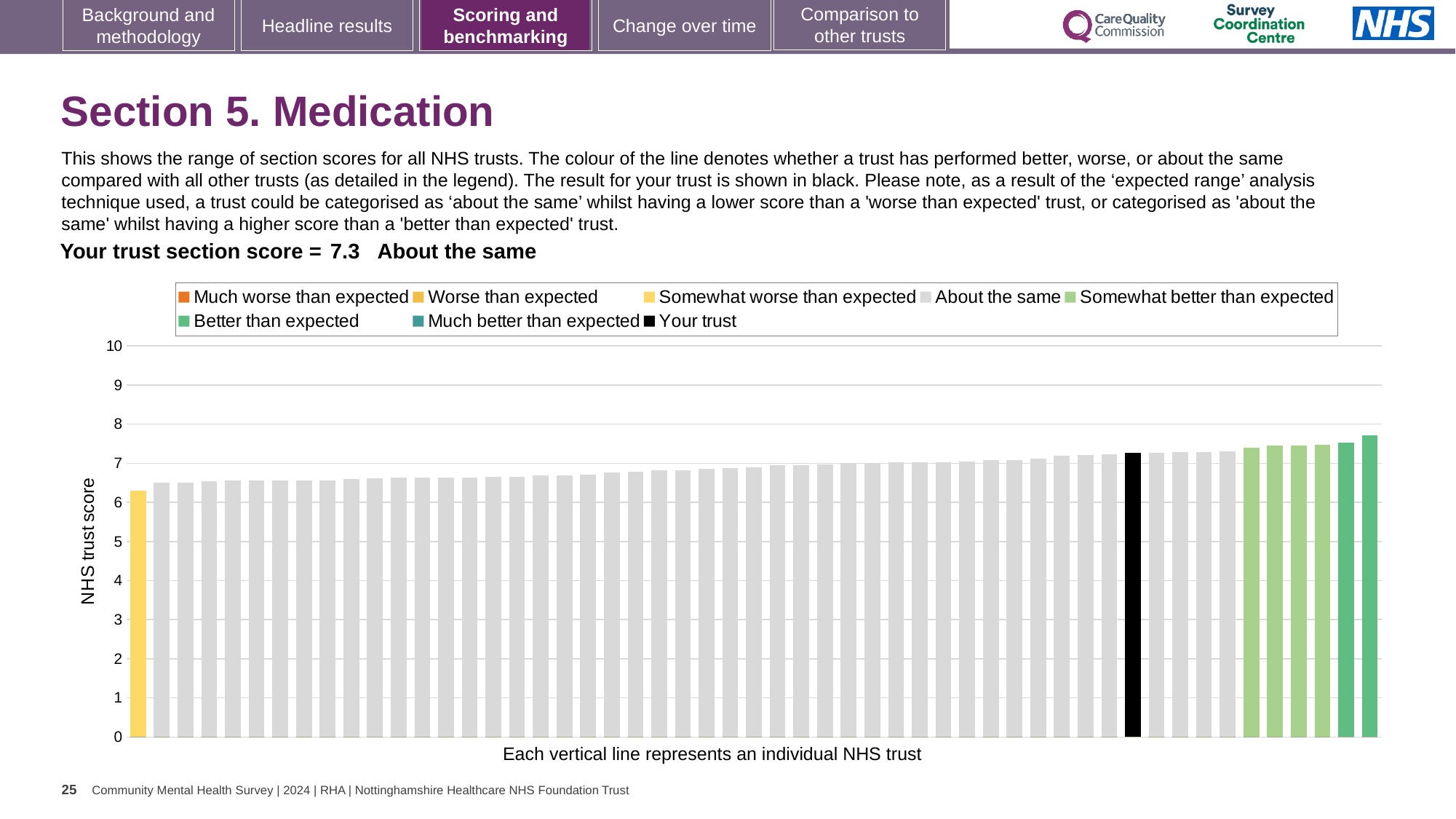
Which performance category is your trust's section score placed in? About the same What is the maximum value shown on the vertical axis? 10 What colour is the bar representing your trust? black What is the label on the vertical axis of the chart? NHS trust score What kind of chart is shown on the slide? bar chart Is the value of the leftmost (lowest) bar greater or less than 6? greater How many entries does the chart legend list? 8 Which of the two is larger: the value of the black 'Your trust' bar or the value of the leftmost yellow bar? the black 'Your trust' bar Is the value of the black 'Your trust' bar greater or less than 7? greater Is the value of the rightmost (highest) bar greater or less than 8? less What is the section score for your trust shown on the slide? 7.3 Do the bar values rise or fall from left to right along the x axis? rise